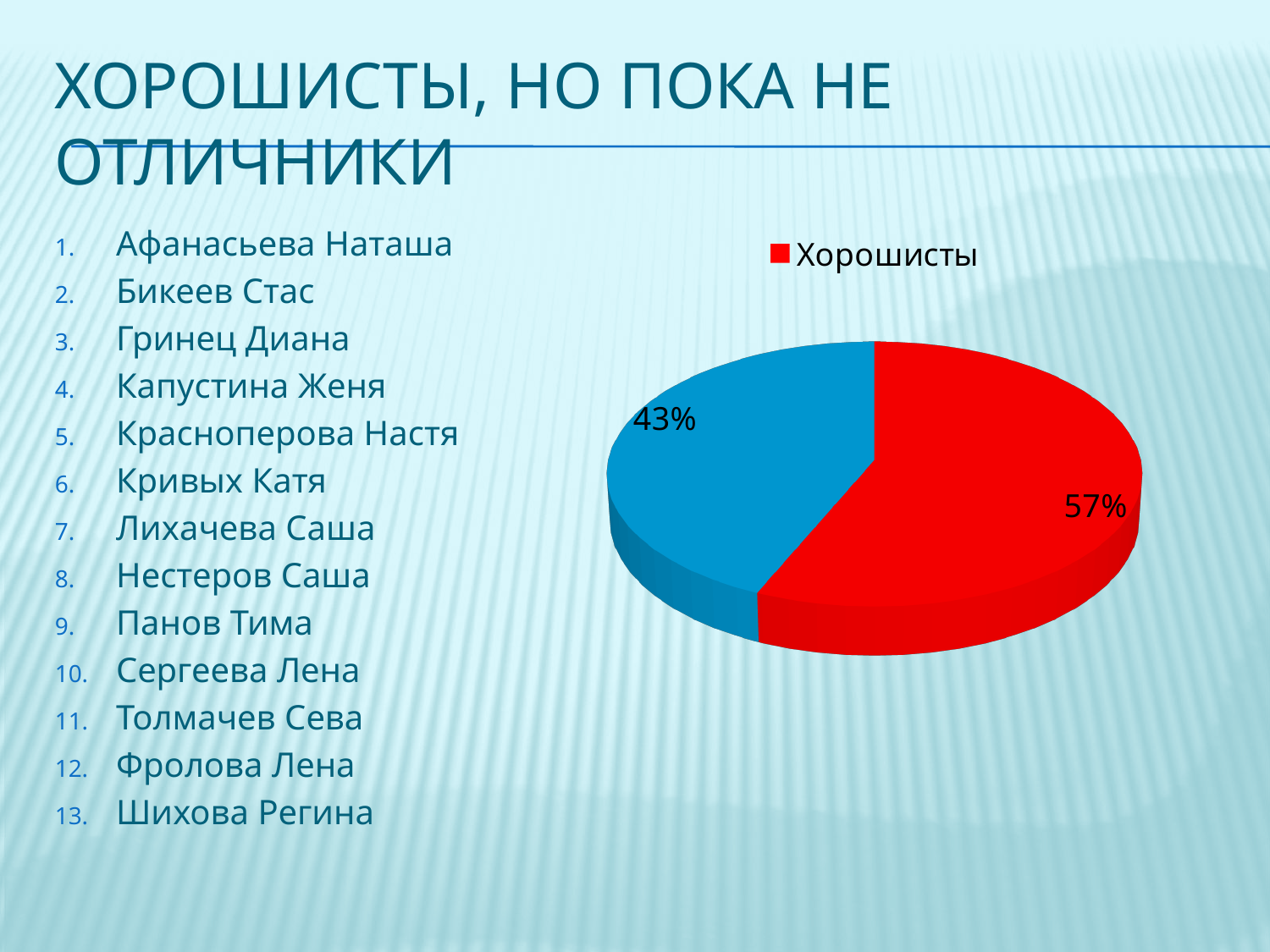
Which is larger, the red slice or the blue slice? the red slice What percentage is shown on the blue slice of the pie chart? 43% What kind of chart is shown on the slide? pie chart What share of the pie does the Хорошисты slice represent? 57% Is the share for Хорошисты greater or less than 50%? greater Which slice of the pie chart is the smallest? the blue slice (43%) What is the difference in percentage points between the red slice and the blue slice? 14 percentage points How many entries does the chart legend list? 1 What is the only entry shown in the chart legend? Хорошисты How many slices does the pie chart have? 2 What colour is the Хорошисты slice in the pie chart? red Which slice of the pie chart is the largest? Хорошисты (red, 57%)